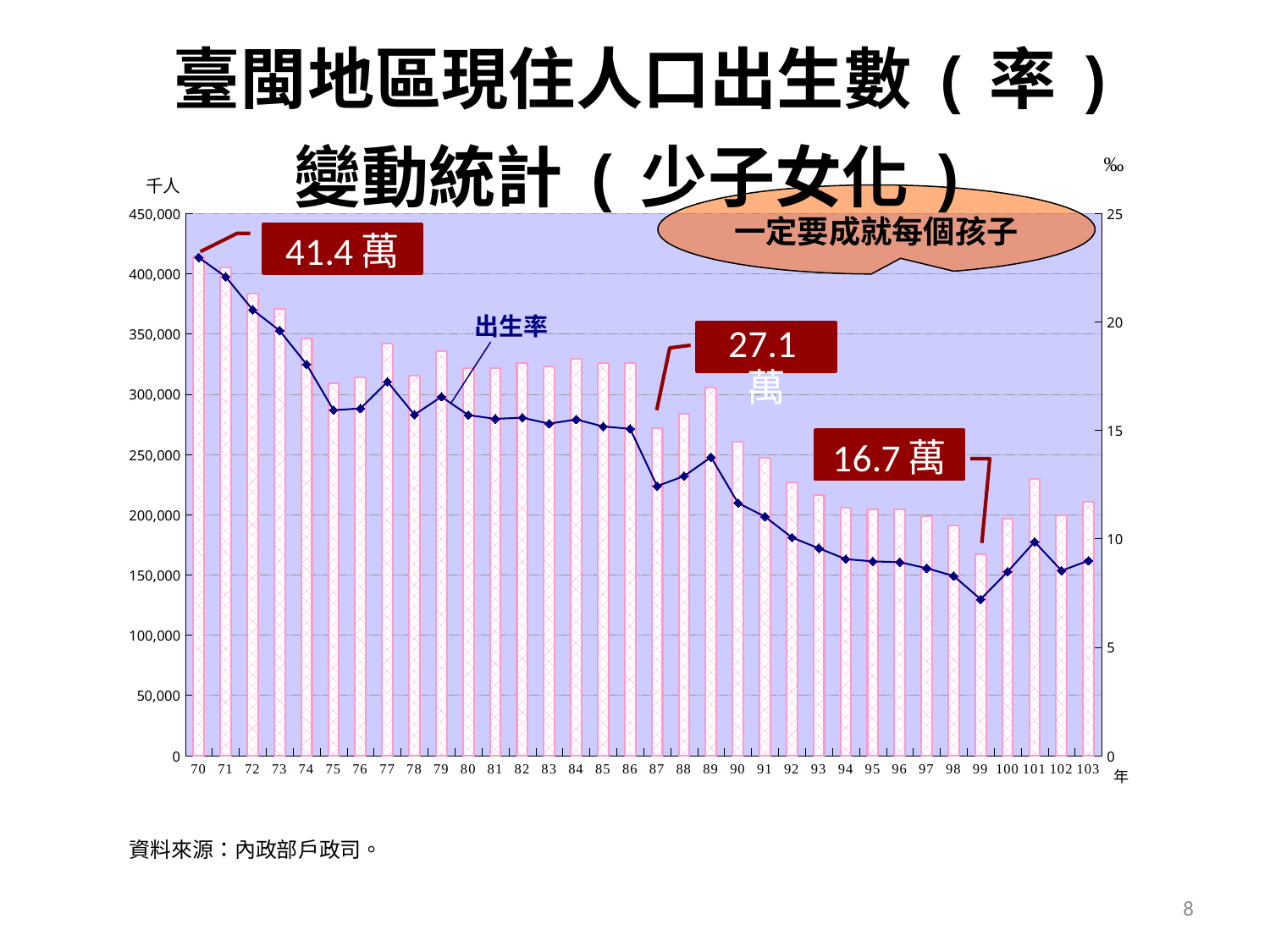
What value does the callout give for the number of births in year 70? 41.4 萬 Do the bar values generally rise or fall from year 70 to year 103? fall Is the bar for year 101 greater or less than 200,000? greater Is the 出生率 line value for year 99 greater or less than 10 on the right axis? less Which year has the lowest bar (smallest number of births)? 99 Which year has the larger bar, year 70 or year 103? 70 What kind of chart is this? Bar chart combined with a line chart Which year has the highest bar (largest number of births)? 70 What value does the callout give for the number of births in year 87? 27.1 萬 Is the bar for year 70 greater or less than 400,000? greater How many years are shown on the x axis? 34 What value does the callout give for the number of births in year 99? 16.7 萬